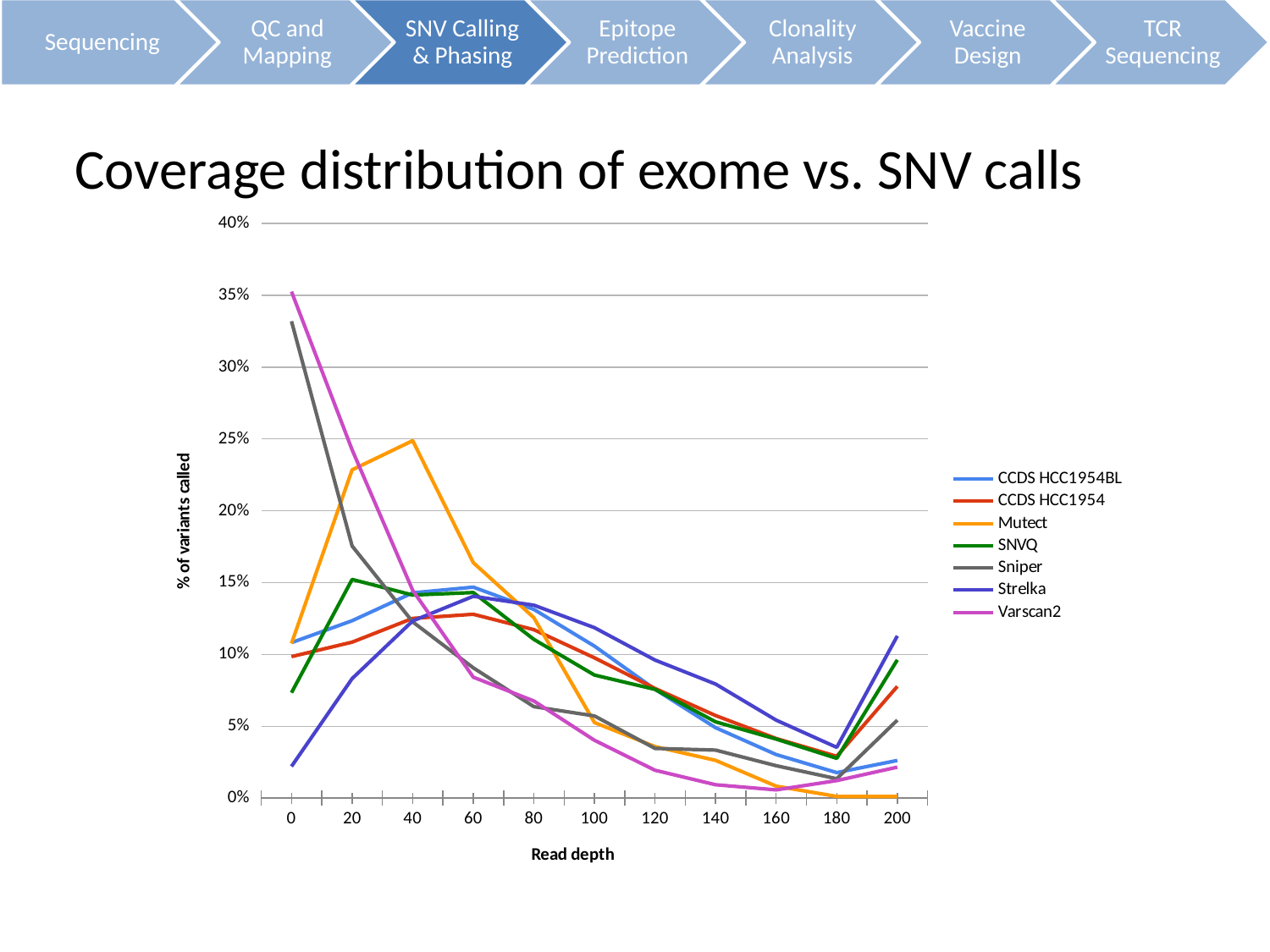
Does the Varscan2 line rise or fall between read depth 0 and read depth 160? fall What kind of chart is shown on the slide? line chart How many read depth values are marked along the x axis? 11 Which series has the highest value at read depth 40? Mutect At read depth 200, which is larger: Mutect or Strelka? Strelka Which series has the lowest value at read depth 0? Strelka Is the value for Mutect at read depth 20 greater or less than 20%? greater Is the value for Varscan2 at read depth 0 greater or less than 30%? greater Is the value for Strelka at read depth 0 greater or less than 5%? less What is the label on the y axis of the chart? % of variants called How many series does the legend list? 7 Which series has the highest value at read depth 0? Varscan2